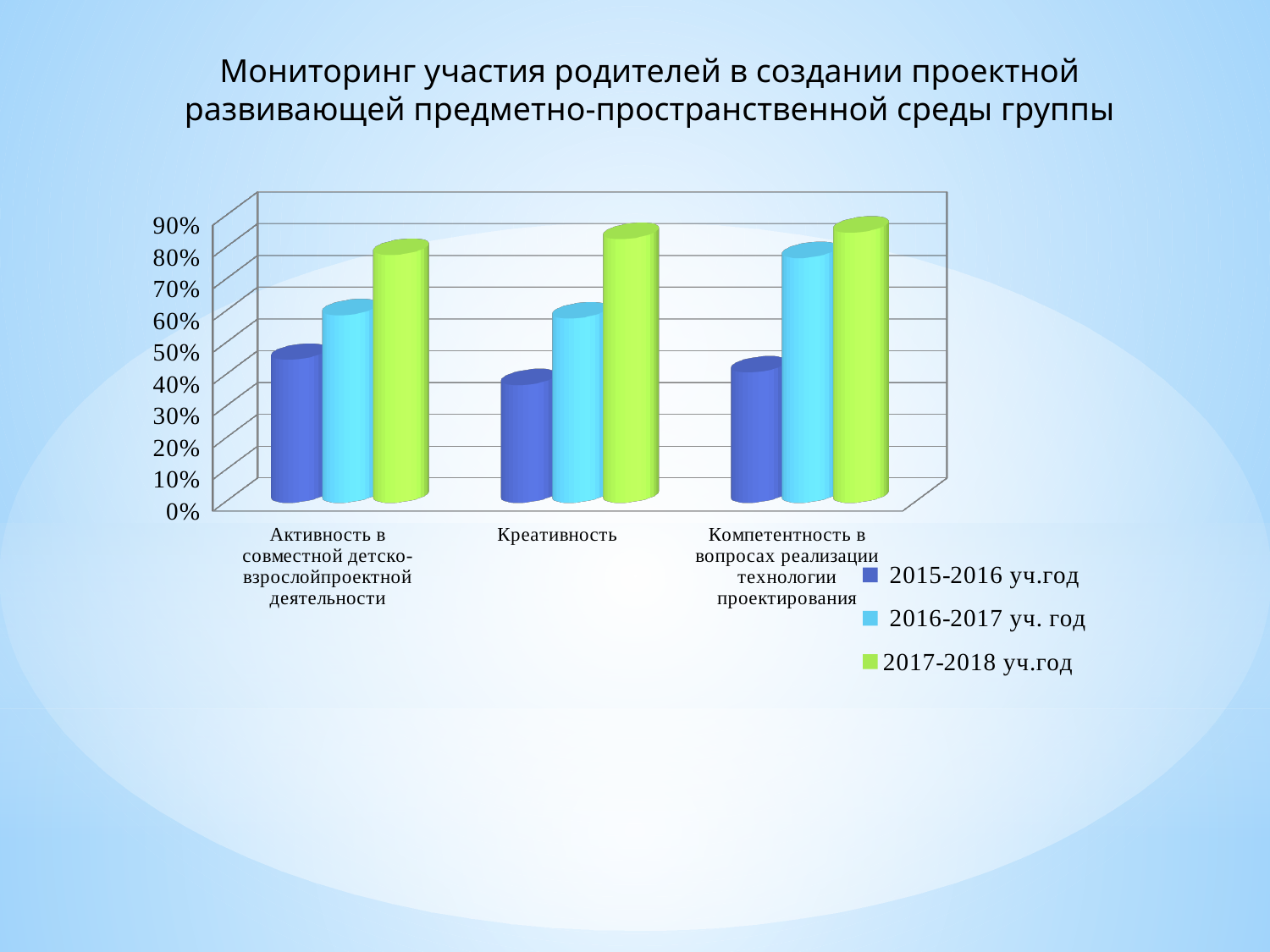
Which colour represents the series 2017-2018 уч.год in the chart? green How many categories are shown on the x axis of the chart? 3 What kind of chart is shown on the slide? bar chart Within the category Креативность, do the values rise or fall from 2015-2016 уч.год to 2017-2018 уч.год? rise Is the value for 2017-2018 уч.год in the category Креативность greater or less than 70%? greater Is the value for 2015-2016 уч.год in the category Креативность greater or less than 50%? less For the series 2016-2017 уч. год, which is larger: the value for Креативность or the value for Компетентность в вопросах реализации технологии проектирования? Компетентность в вопросах реализации технологии проектирования Is the value for 2017-2018 уч.год in the category Активность в совместной детско-взрослой проектной деятельности greater or less than 70%? greater Which series has the highest value in the category Креативность? 2017-2018 уч.год Which category has the highest value for the series 2016-2017 уч. год? Компетентность в вопросах реализации технологии проектирования How many series does the chart legend list? 3